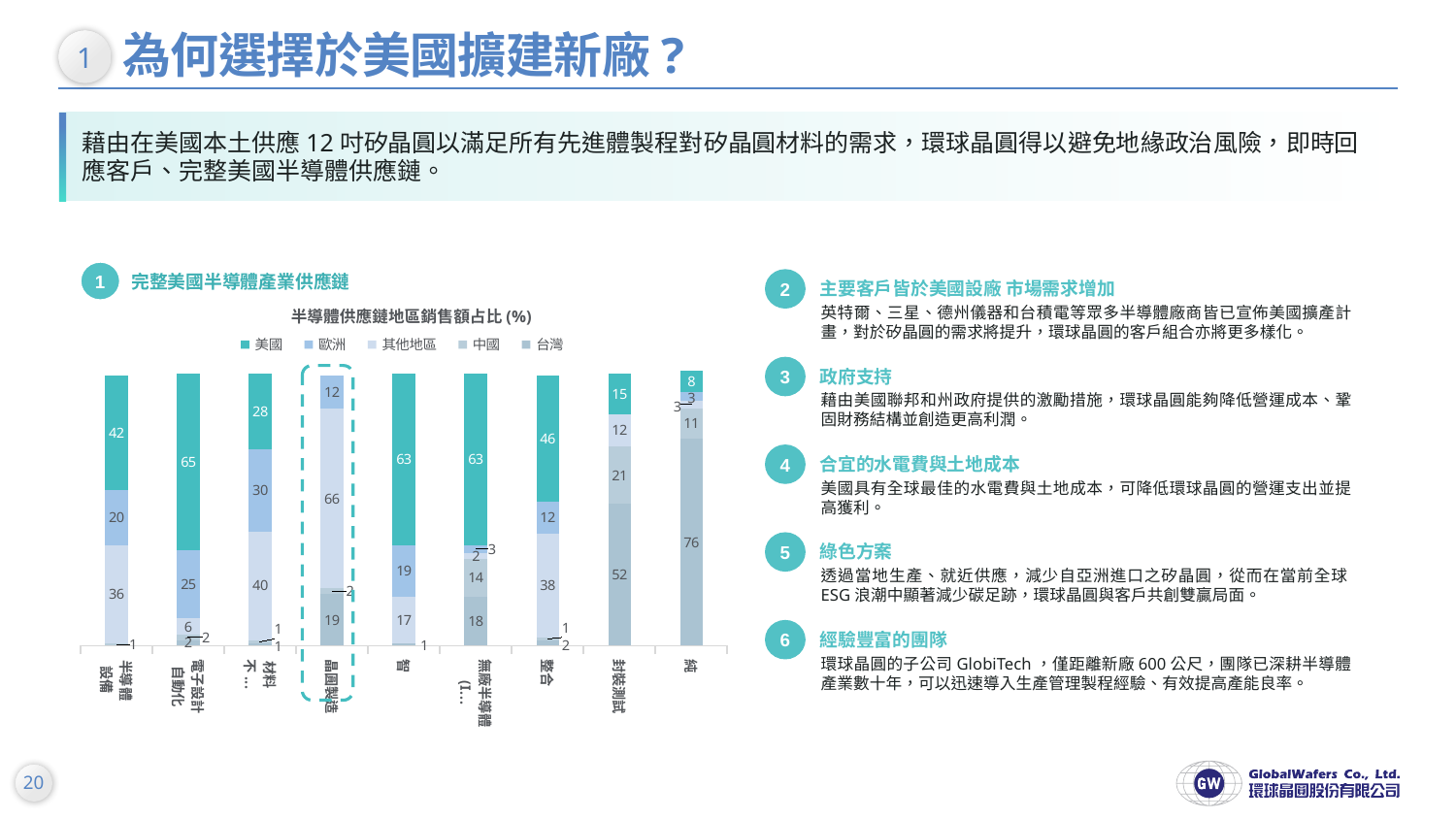
How many categories (bars) are plotted in the chart? 9 How many series does the legend of the chart list? 5 What is the 美國 share for 半導體設備? 42 What is the title of the chart? 半導體供應鏈地區銷售額占比 (%) What is the 美國 share for 整合? 46 What is the 美國 share for 電子設計自動化? 65 Which category has the highest 美國 share? 電子設計自動化 What kind of chart is shown on the slide? stacked bar chart What is the largest segment value in the 晶圓製造 bar? 66 Which is larger, the 美國 share for 半導體設備 or for 整合? 整合 What is the difference between the 美國 share for 電子設計自動化 and for 半導體設備? 23 What is the largest segment value in the 封裝測試 bar? 52